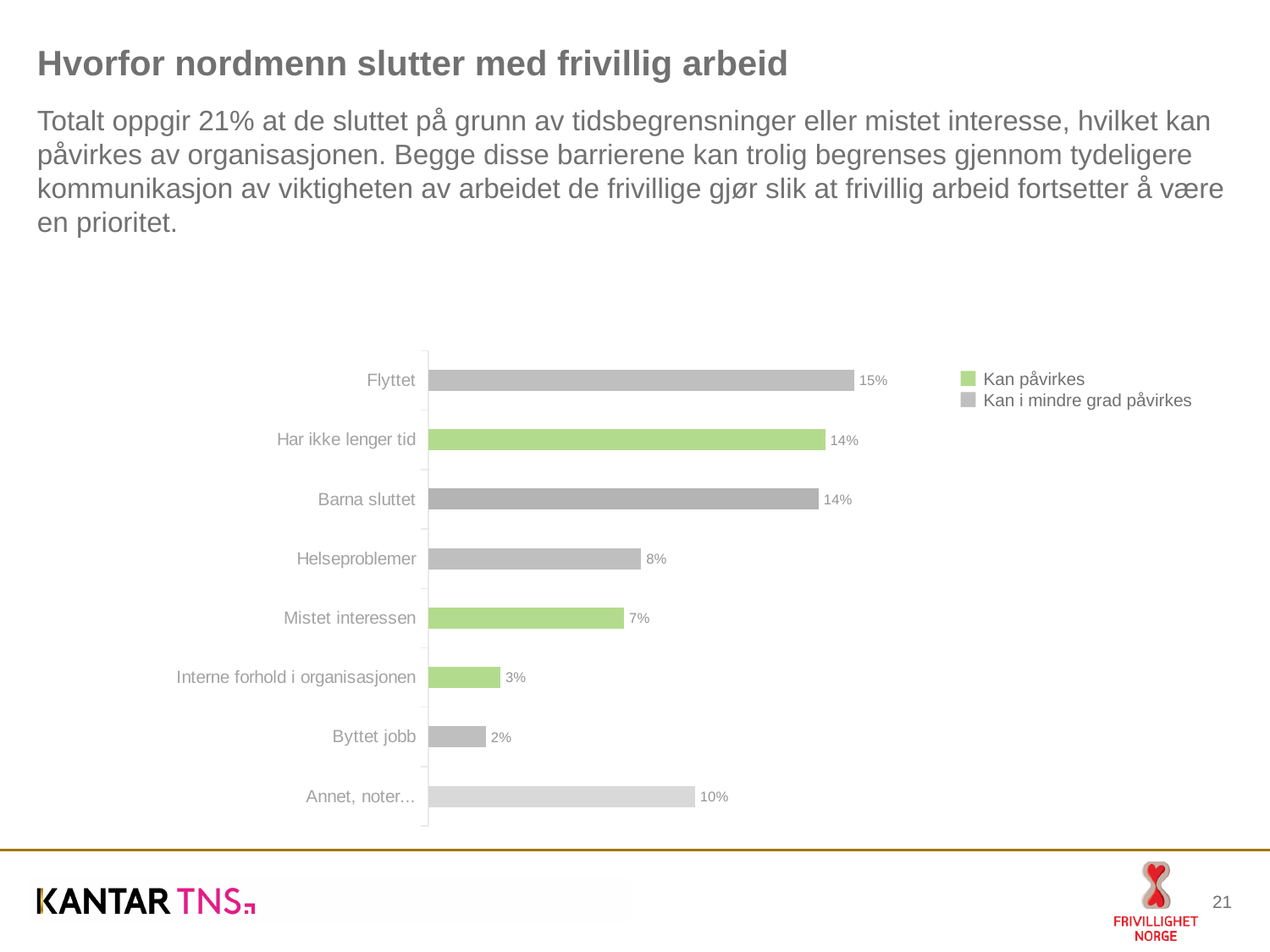
Which is larger, the value for Helseproblemer or the value for Byttet jobb? Helseproblemer What is the value for Helseproblemer? 8% What is the value for Interne forhold i organisasjonen? 3% Which category has the lowest value? Byttet jobb How many categories are shown in the chart? 8 Which category has the highest value? Flyttet How many series does the legend list? 2 What kind of chart is shown on the slide? Bar chart What is the value for Flyttet? 15% Which legend entry is shown in green? Kan påvirkes What is the value for Har ikke lenger tid? 14% What is the difference between the values for Flyttet and Mistet interessen? 8%